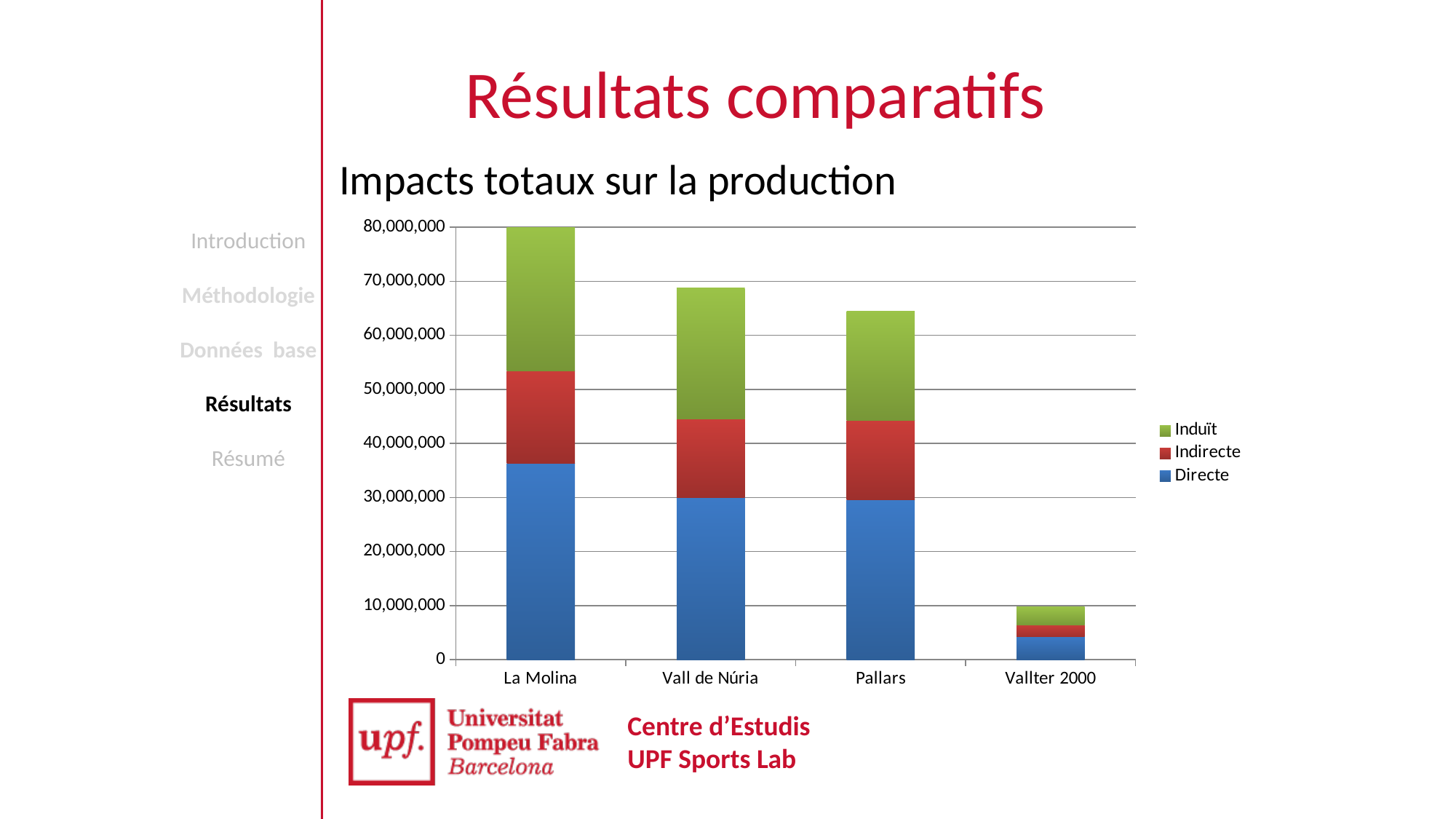
What kind of chart is shown on the slide? stacked bar chart Which category has the highest total stacked bar? La Molina How many categories are shown on the x axis of the chart? 4 Is the Directe value for Vallter 2000 greater or less than 10,000,000? less Which series is shown in green in the chart legend? Induït Which category has the lowest total stacked bar? Vallter 2000 Is the total bar for La Molina greater or less than 70,000,000? greater How many series does the chart legend list? 3 Is the Directe value for La Molina greater or less than 30,000,000? greater Which has a larger total bar, Vall de Núria or Pallars? Vall de Núria Do the total bar heights rise or fall from left to right across the categories? fall